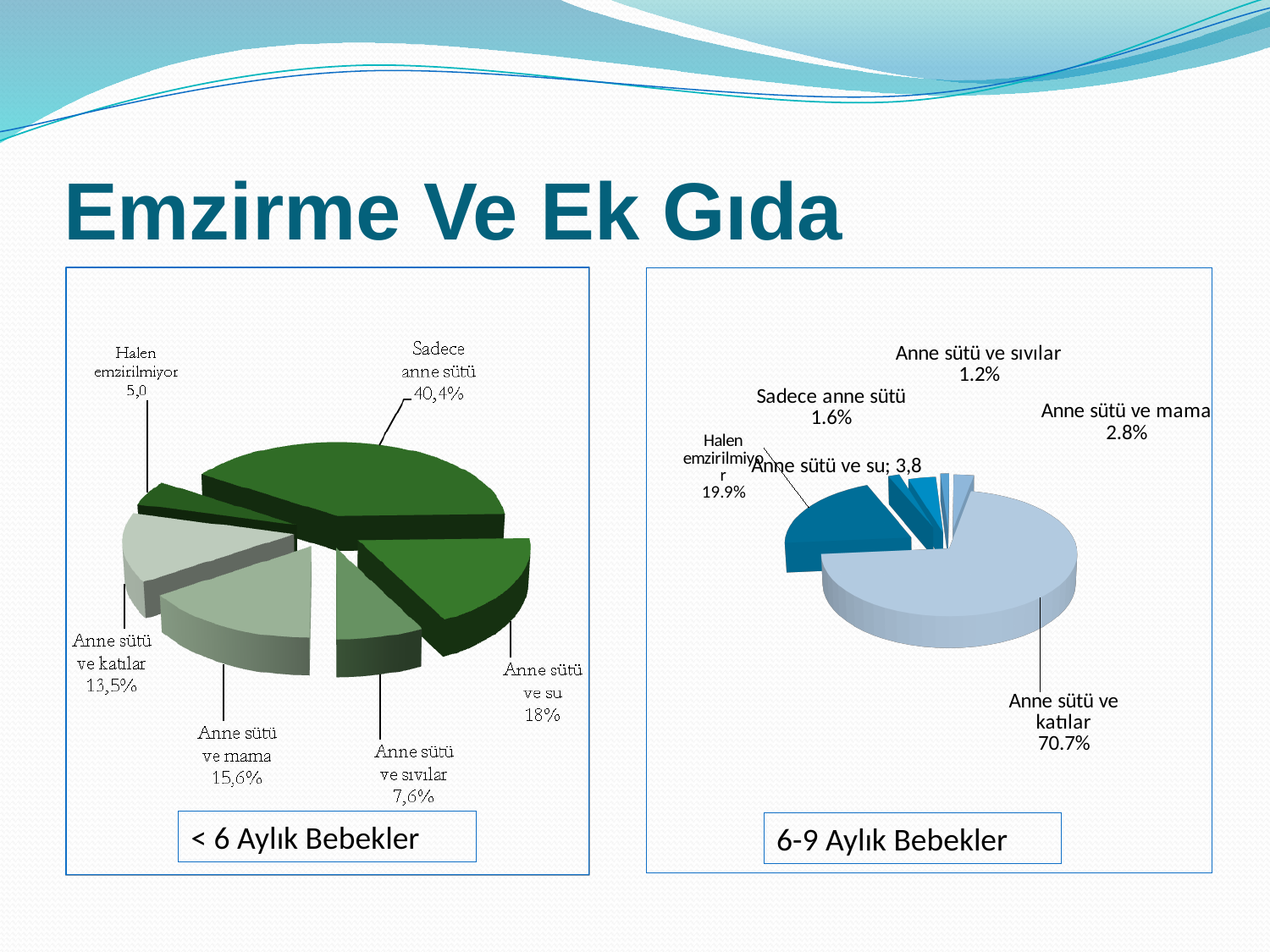
In the '< 6 Aylık Bebekler' chart, which category has the largest slice? Sadece anne sütü In the '< 6 Aylık Bebekler' chart, which category has the smallest slice? Halen emzirilmiyor In the '6-9 Aylık Bebekler' chart, what is the difference between 'Anne sütü ve katılar' and 'Halen emzirilmiyor'? 50.8% In the '< 6 Aylık Bebekler' chart, what is the value for 'Anne sütü ve mama'? 15,6% In the '< 6 Aylık Bebekler' chart, what is the value for 'Halen emzirilmiyor'? 5,0 In the '6-9 Aylık Bebekler' chart, which is larger: 'Sadece anne sütü' or 'Anne sütü ve mama'? Anne sütü ve mama What type of chart is shown on the left side of the slide? Pie chart In the '< 6 Aylık Bebekler' chart, what is the value for 'Sadece anne sütü'? 40,4% In the '6-9 Aylık Bebekler' chart, which category has the smallest slice? Anne sütü ve sıvılar In the '6-9 Aylık Bebekler' chart, what is the value for 'Anne sütü ve katılar'? 70.7% In the '6-9 Aylık Bebekler' chart, what is the value for 'Halen emzirilmiyor'? 19.9% In the '< 6 Aylık Bebekler' chart, how many slices does the pie have? 6